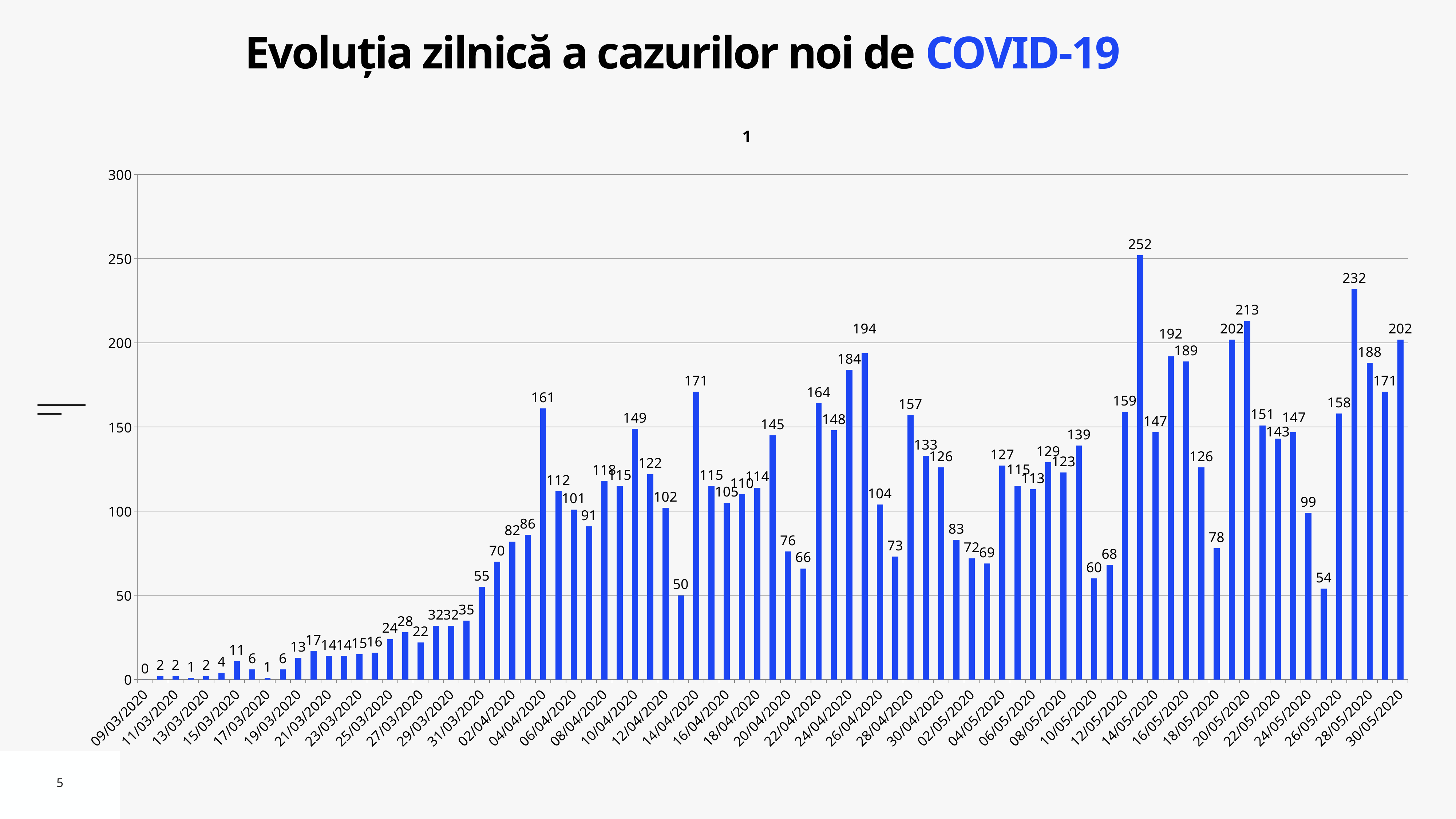
What is the highest daily value shown in the chart? 252 Which is larger, the bar labelled 252 or the bar labelled 232? 252 What is the value for 30/05/2020? 202 Which date has the lowest value in the chart? 09/03/2020 What is the value for 09/03/2020? 0 What is the maximum value shown on the vertical axis? 300 What is the title of the slide? Evoluția zilnică a cazurilor noi de COVID-19 What kind of chart is shown on the slide? bar chart What is the difference between the highest value (252) and the value for 30/05/2020? 50 Is the value for 30/05/2020 greater or less than 200? greater How many bars have a value of 250 or more? 1 Do the values generally rise or fall from March to May along the x axis? rise